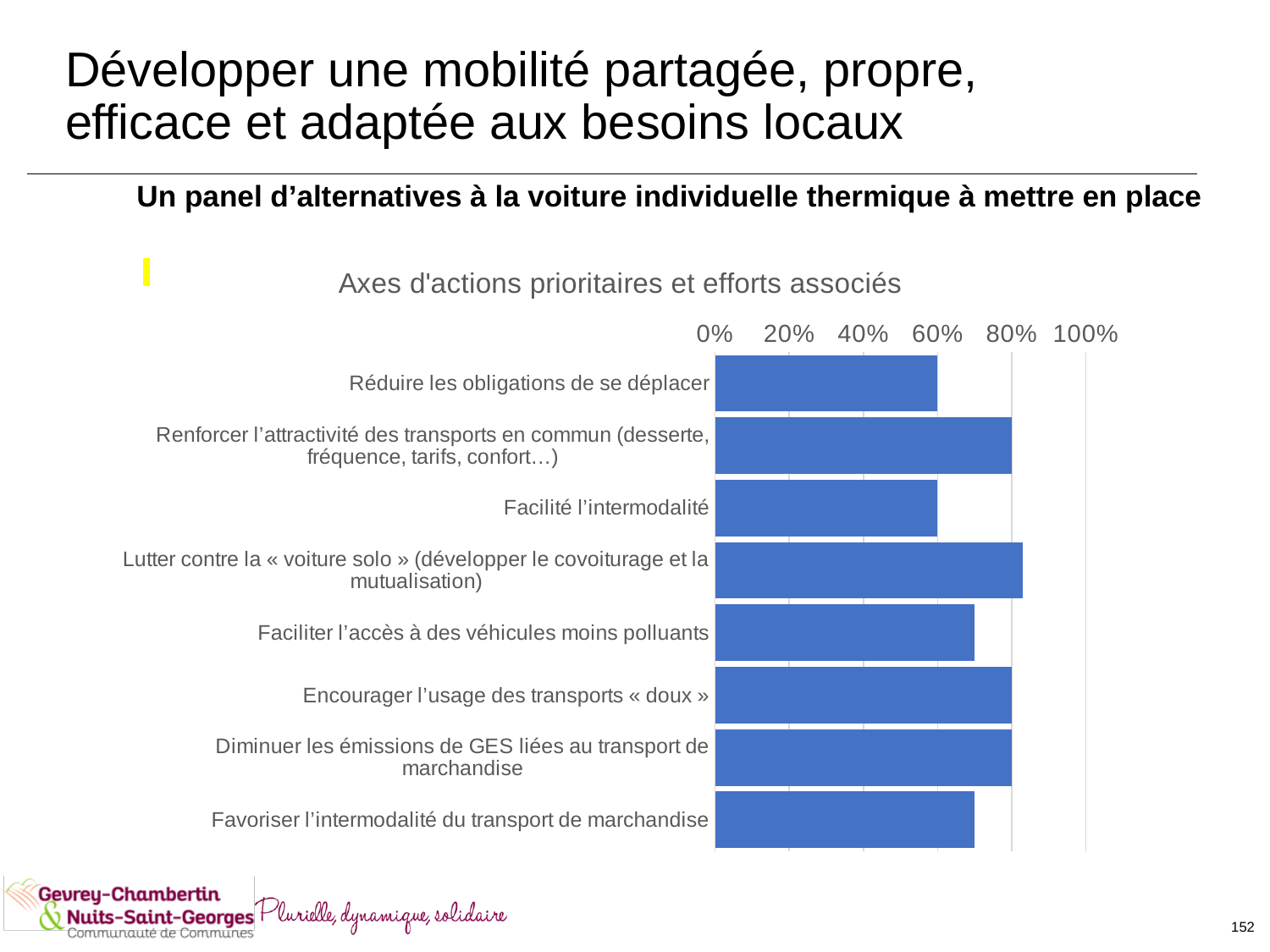
Is the value for "Faciliter l'accès à des véhicules moins polluants" greater or less than 60%? greater What is the title of the chart? Axes d'actions prioritaires et efforts associés What kind of chart is shown on the slide? Bar chart Which is larger: the value for "Diminuer les émissions de GES liées au transport de marchandise" or for "Favoriser l'intermodalité du transport de marchandise"? Diminuer les émissions de GES liées au transport de marchandise Which category has the longest bar in the chart? Lutter contre la « voiture solo » (développer le covoiturage et la mutualisation) What is the value for "Réduire les obligations de se déplacer"? 60% Which is larger: the value for "Renforcer l'attractivité des transports en commun" or for "Facilité l'intermodalité"? Renforcer l'attractivité des transports en commun Is the value for "Favoriser l'intermodalité du transport de marchandise" greater or less than 80%? less What is the highest value shown on the chart's percentage axis? 100% What is the value for "Encourager l'usage des transports « doux »"? 80% How many categories (action axes) are plotted in the chart? 8 Is the value for "Lutter contre la « voiture solo »" greater or less than 80%? greater